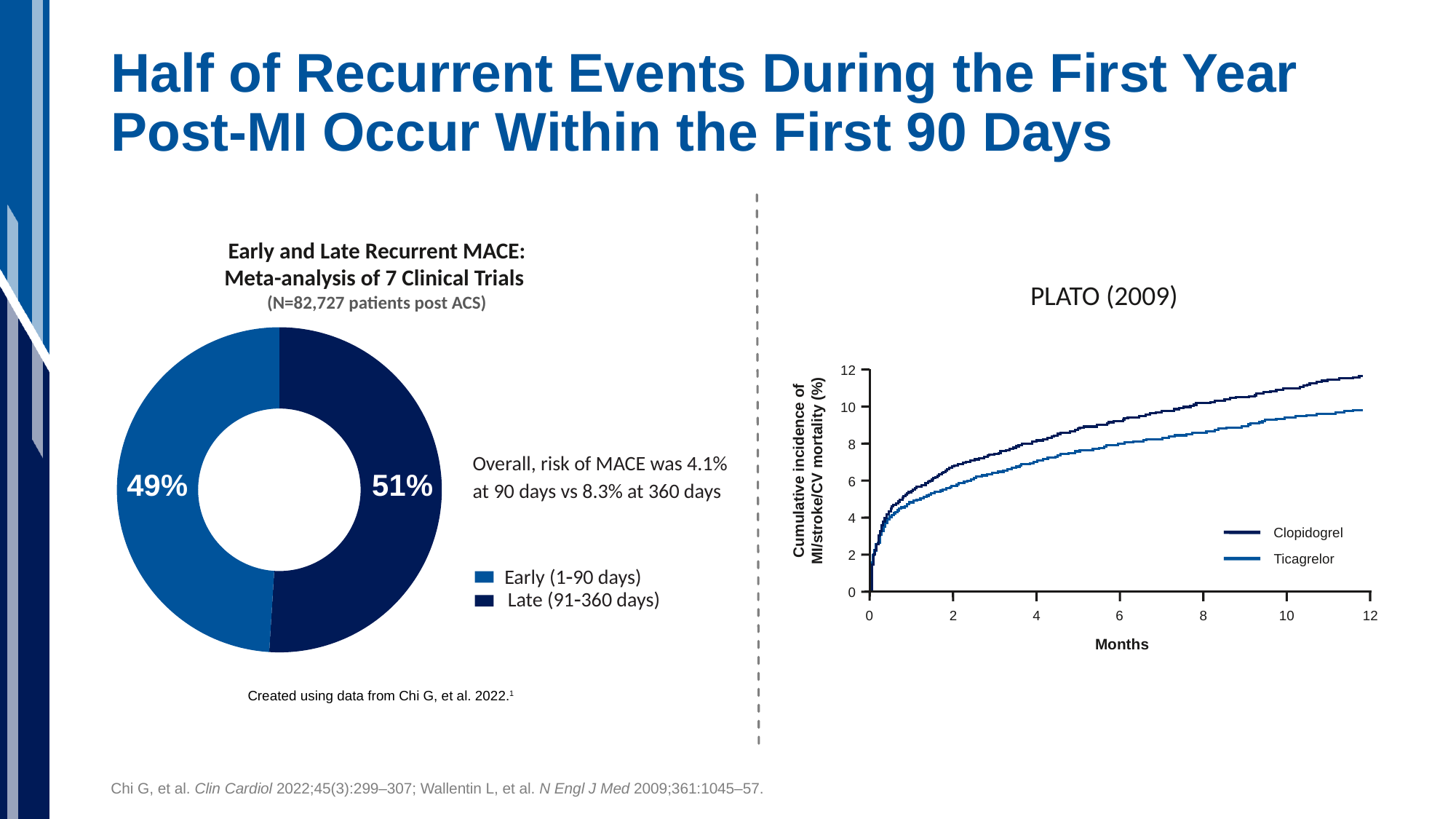
In the 'Early and Late Recurrent MACE' chart, what percentage is shown for Early (1-90 days)? 49% In the 'Early and Late Recurrent MACE' chart, which segment is larger, Early (1-90 days) or Late (91-360 days)? Late (91-360 days) In the 'Early and Late Recurrent MACE' chart, what is the difference in percentage points between the Late and Early segments? 2 In the 'Early and Late Recurrent MACE' chart, what percentage is shown for Late (91-360 days)? 51% How many series does the legend of the 'PLATO (2009)' chart list? 2 In the 'PLATO (2009)' chart, do the cumulative incidence curves rise or fall as months increase? Rise In the 'PLATO (2009)' chart, which series has the higher cumulative incidence at 12 months, Clopidogrel or Ticagrelor? Clopidogrel What kind of chart is the 'PLATO (2009)' chart on the right? Line chart What kind of chart is the 'Early and Late Recurrent MACE' chart on the left? Pie (donut) chart How many segments does the 'Early and Late Recurrent MACE' chart have? 2 What is the label of the x axis in the 'PLATO (2009)' chart? Months